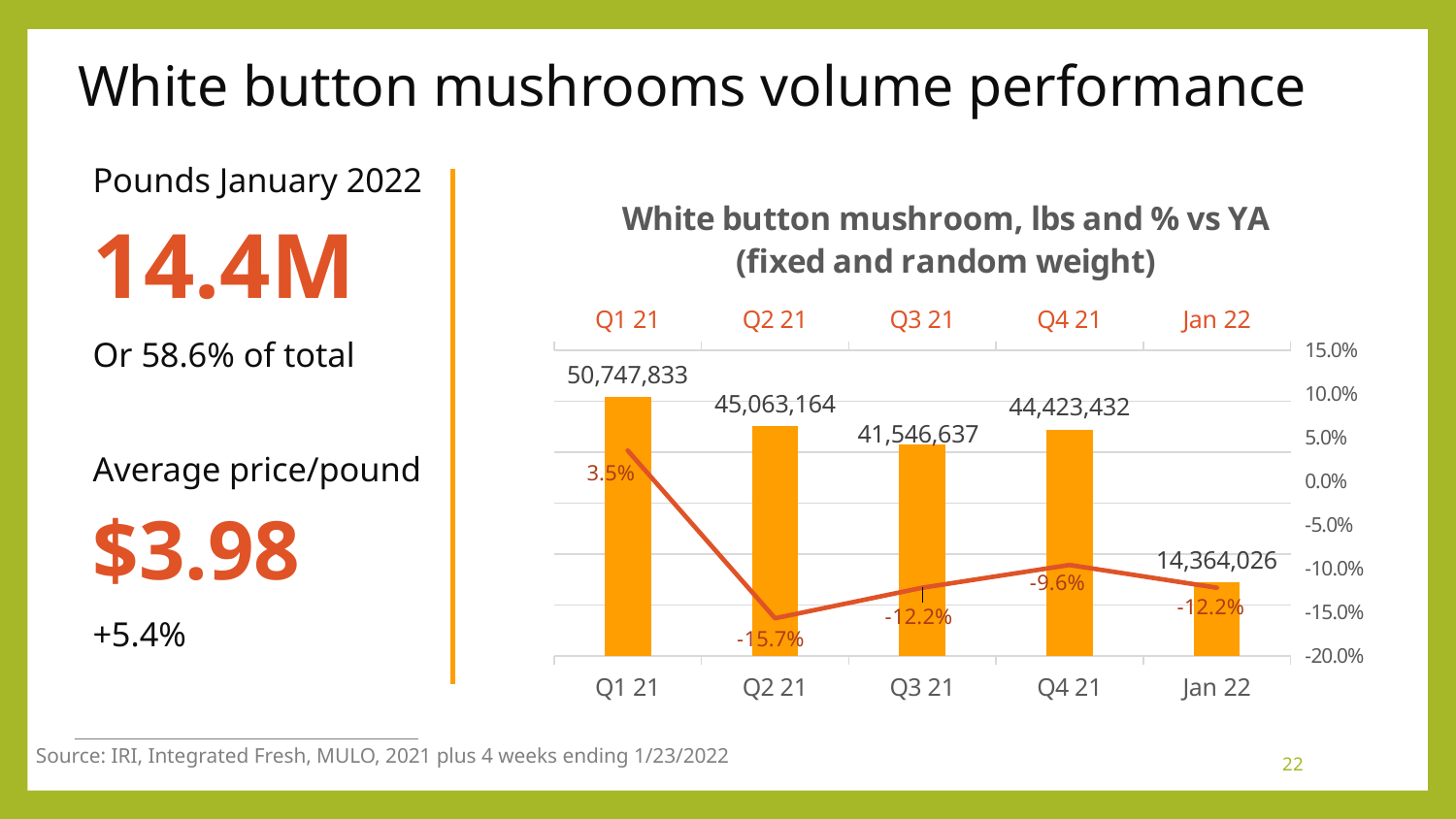
Which period has the lowest pounds value? Jan 22 What is the % vs YA value for Q2 21? -15.7% What is the pounds value for Jan 22? 14,364,026 Which has a higher pounds value, Q3 21 or Q4 21? Q4 21 What is the title of the chart? White button mushroom, lbs and % vs YA (fixed and random weight) Which period has the lowest % vs YA value? Q2 21 What is the % vs YA value for Q4 21? -9.6% What is the difference in pounds between Q1 21 and Q2 21? 5,684,669 Which period has the highest pounds value? Q1 21 How many periods are shown on the x axis? 5 What kind of chart is this? Combined bar and line chart What is the pounds value for Q1 21? 50,747,833